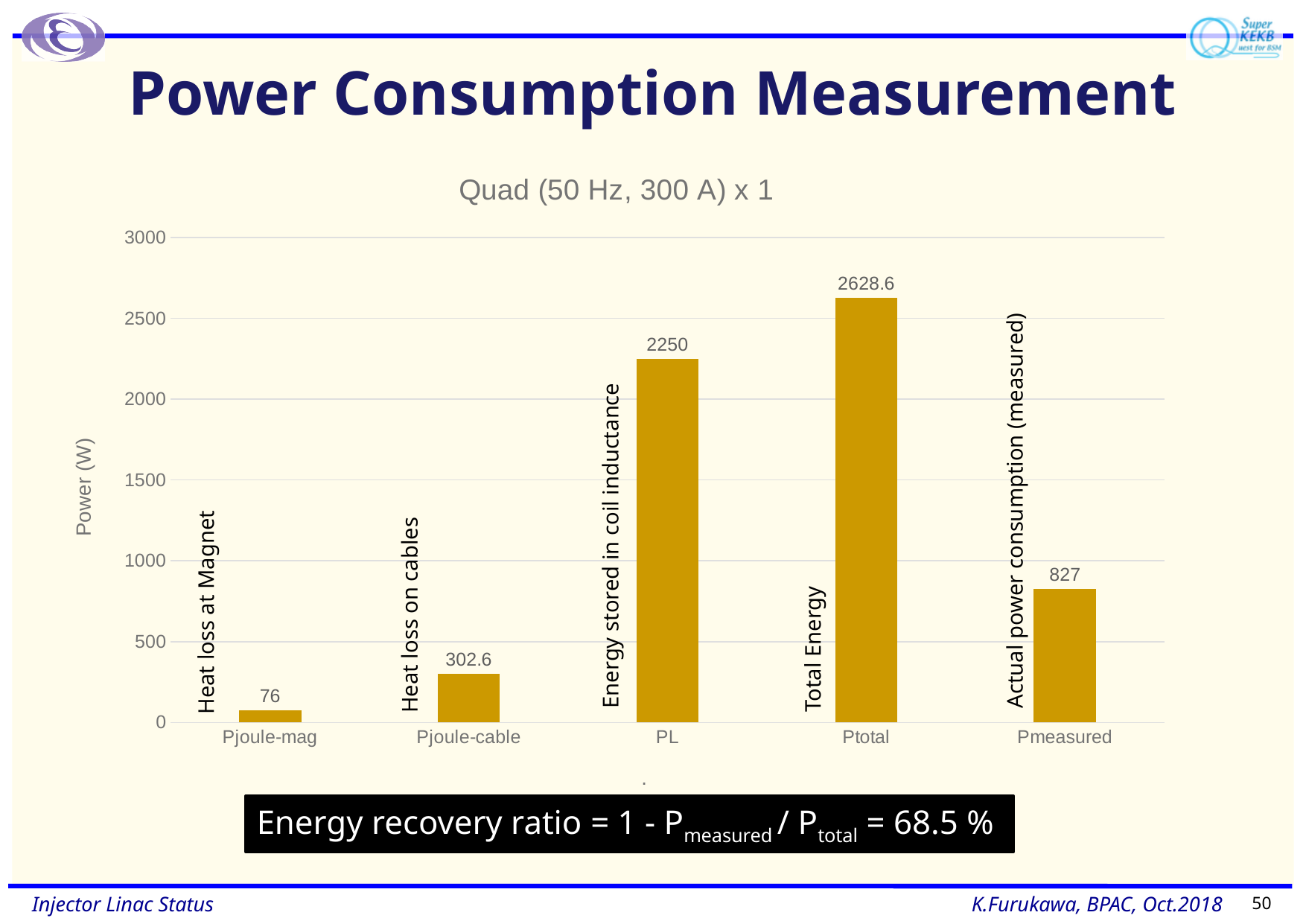
What is the value for Pmeasured? 827 What is the value for Pjoule-cable? 302.6 Which category has the highest value? Ptotal Which is larger, PL or Pmeasured? PL Which category has the lowest value? Pjoule-mag What is the value for Ptotal? 2628.6 Is the value for PL greater or less than 2000? greater What is the difference between Pjoule-cable and Pjoule-mag? 226.6 What is the difference between Ptotal and Pmeasured? 1801.6 What is the title of the chart? Quad (50 Hz, 300 A) x 1 How many categories are shown on the x axis? 5 What kind of chart is shown? bar chart